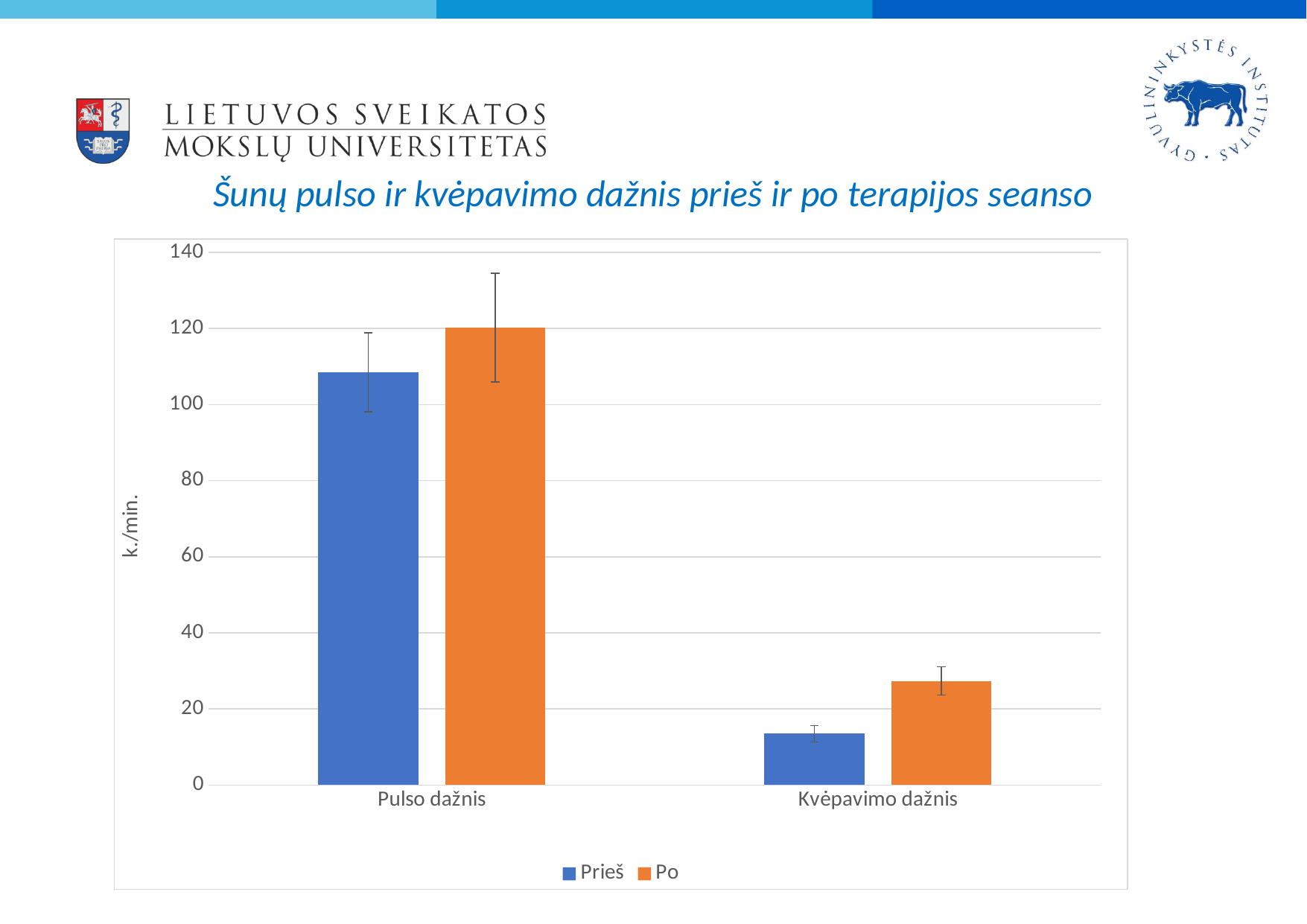
Is the value for Po in the Kvėpavimo dažnis category greater or less than 20? greater What is the label on the vertical axis? k./min. Which bar is the tallest in the chart? Po, Pulso dažnis In the Kvėpavimo dažnis category, which series has the larger value, Prieš or Po? Po What kind of chart is shown on the slide? bar chart Is the value for Prieš in the Pulso dažnis category greater or less than 120? less Is the value for Po in the Pulso dažnis category greater or less than 100? greater How many categories are shown on the x axis? 2 How many series does the legend list? 2